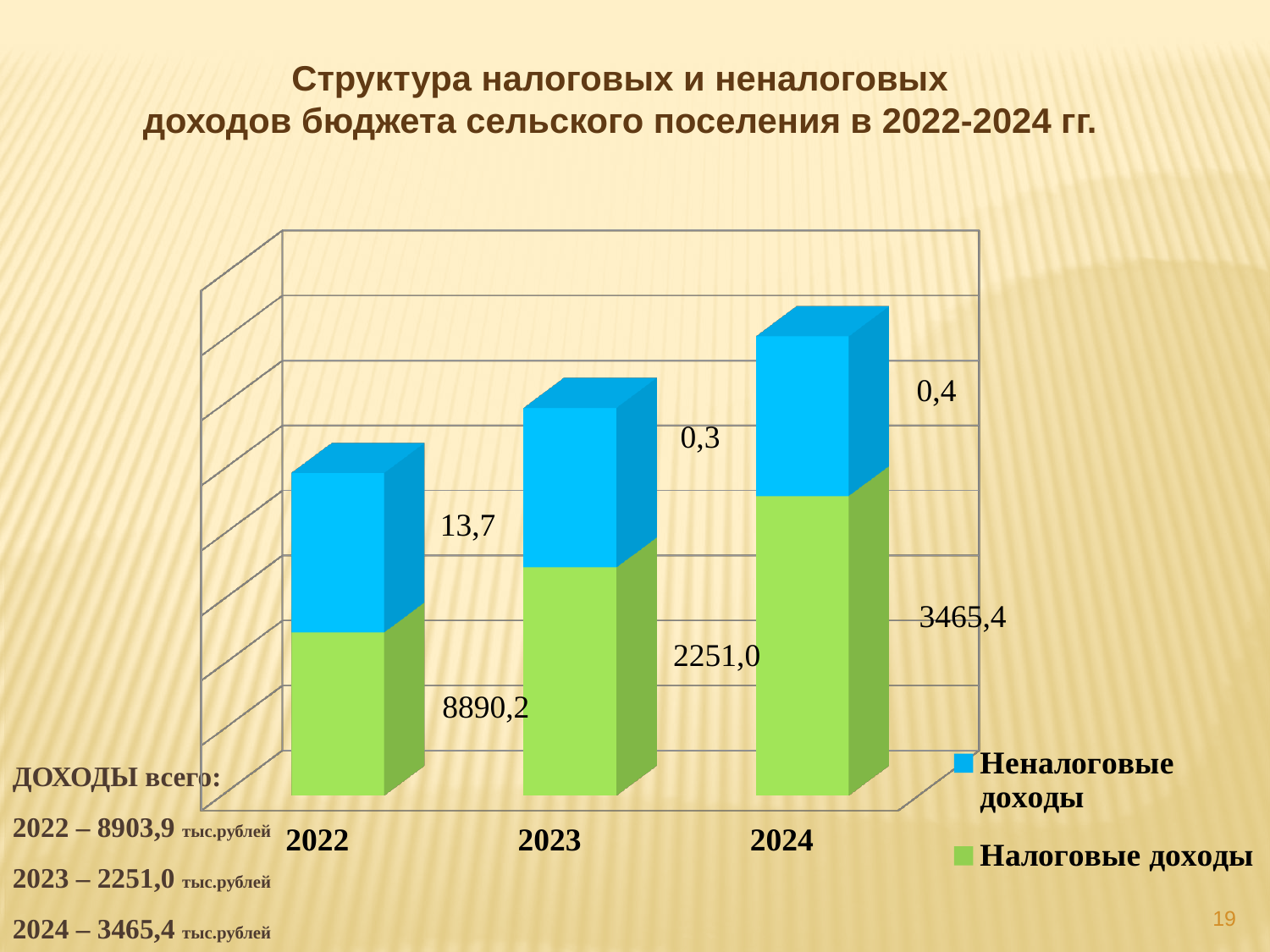
What kind of chart is shown on the slide? Stacked bar chart What is the total of the 2022 bar (Налоговые доходы plus Неналоговые доходы)? 8903,9 What is the value of Неналоговые доходы for 2024? 0,4 What is the value of Налоговые доходы for 2024? 3465,4 How many series does the legend list? 2 What is the value of Неналоговые доходы for 2023? 0,3 What is the difference between Налоговые доходы in 2024 and in 2023? 1214,4 What is the value of Налоговые доходы for 2022? 8890,2 How many years are shown on the x axis? 3